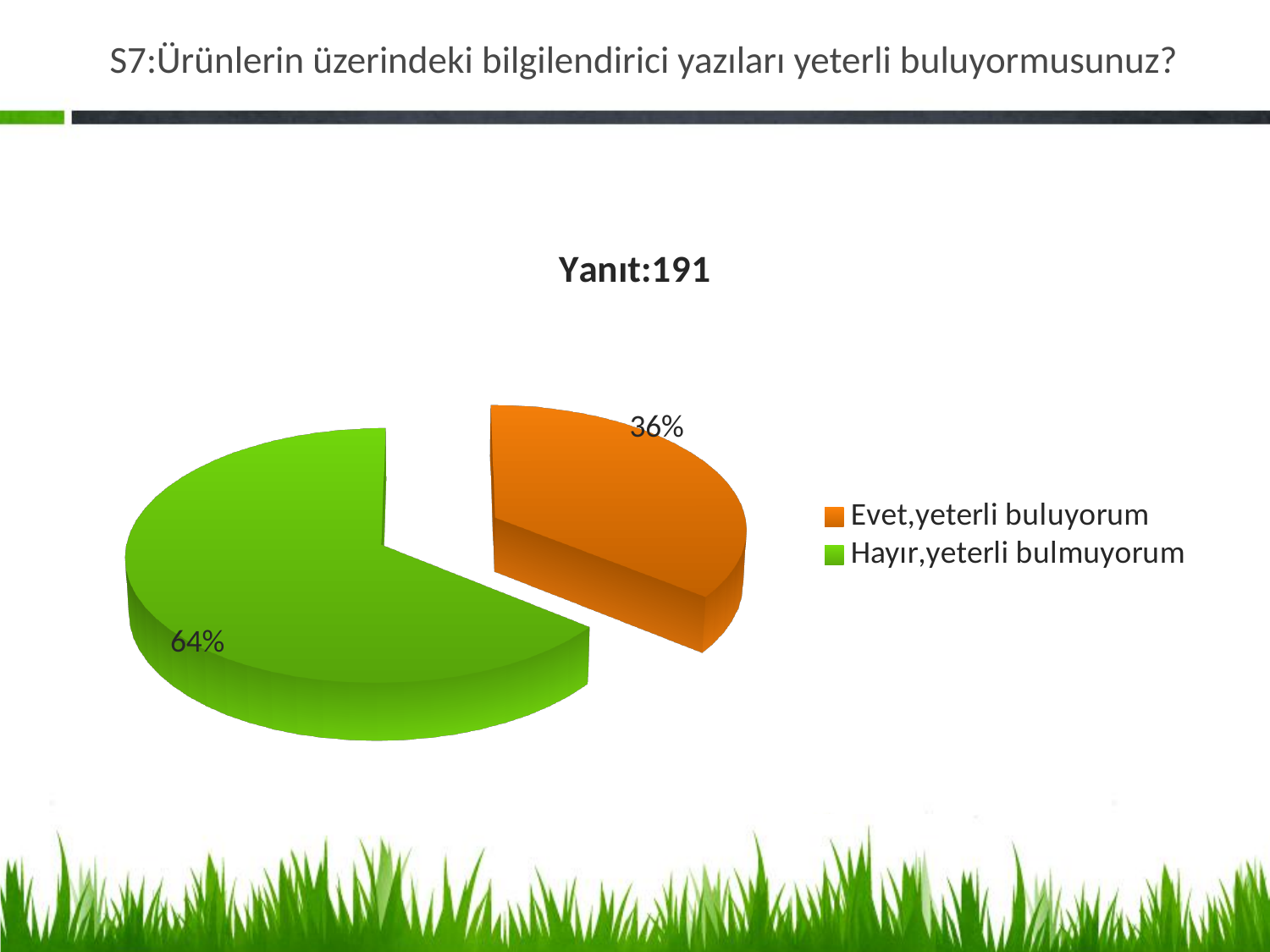
What percentage of the pie chart is labelled "Hayır,yeterli bulmuyorum"? 64% Which slice is larger: "Evet,yeterli buluyorum" or "Hayır,yeterli bulmuyorum"? Hayır,yeterli bulmuyorum What is the combined share of the two slices in the pie chart? 100% Which category has the smallest share of the pie chart? Evet,yeterli buluyorum Which category has the largest share of the pie chart? Hayır,yeterli bulmuyorum What kind of chart is shown on the slide? Pie chart How many slices does the pie chart have? 2 What percentage of the pie chart is labelled "Evet,yeterli buluyorum"? 36% What is the title of the chart? Yanıt:191 What colour is the "Evet,yeterli buluyorum" slice? Orange How many entries does the legend list? 2 What is the difference in percentage points between the "Hayır,yeterli bulmuyorum" and "Evet,yeterli buluyorum" slices? 28